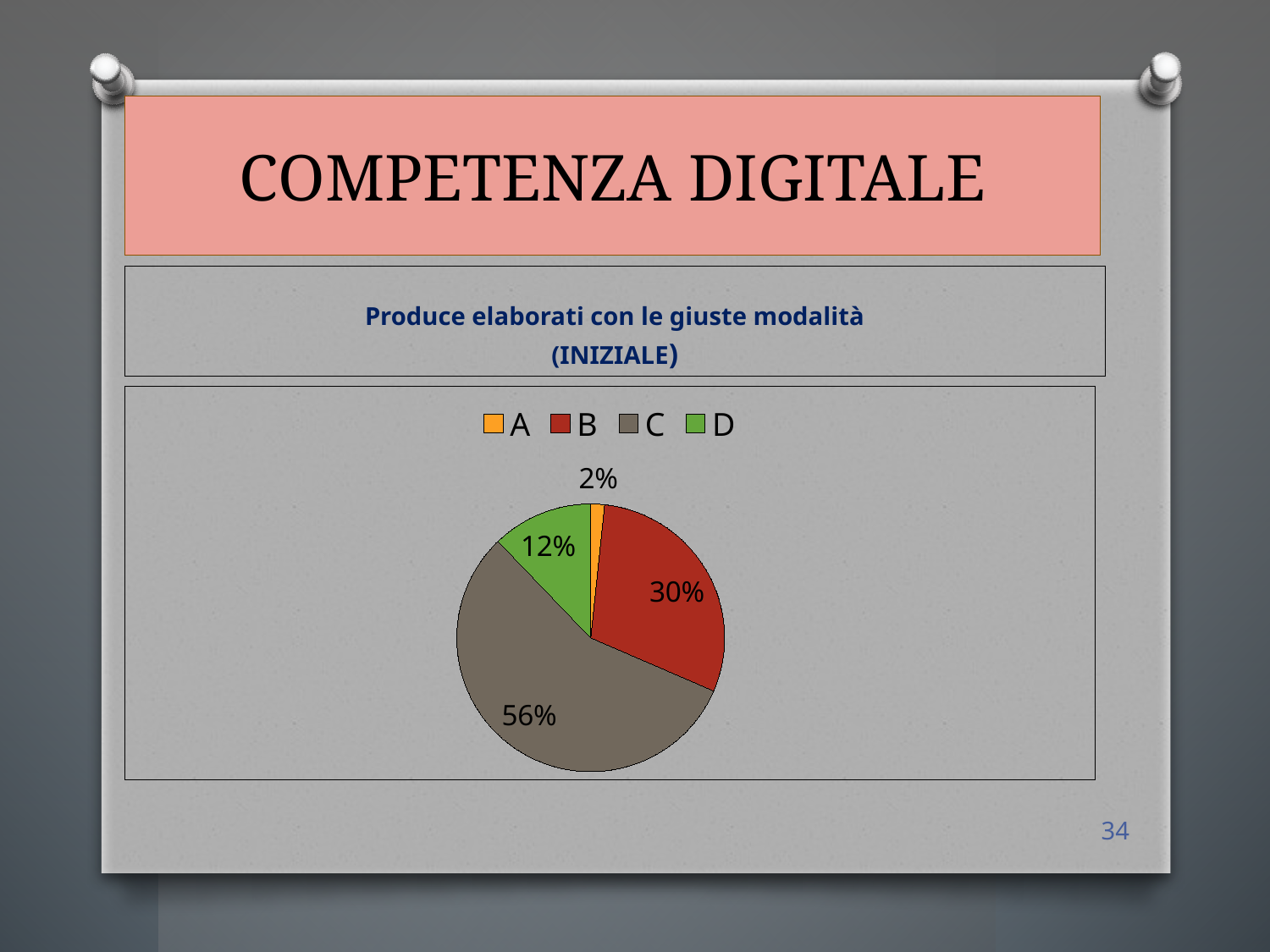
What percentage does slice D represent in the pie chart? 12% What percentage does slice A represent in the pie chart? 2% What percentage does slice C represent in the pie chart? 56% Which is larger, slice B or slice D? B How many slices does the pie chart have? 4 What percentage does slice B represent in the pie chart? 30% What is the difference in percentage points between slice C and slice B? 26 What is the difference in percentage points between slice D and slice A? 10 Which category has the smallest slice in the pie chart? A What kind of chart is shown on the slide? pie chart Which category has the largest slice in the pie chart? C What colour is the slice for category D in the pie chart? green